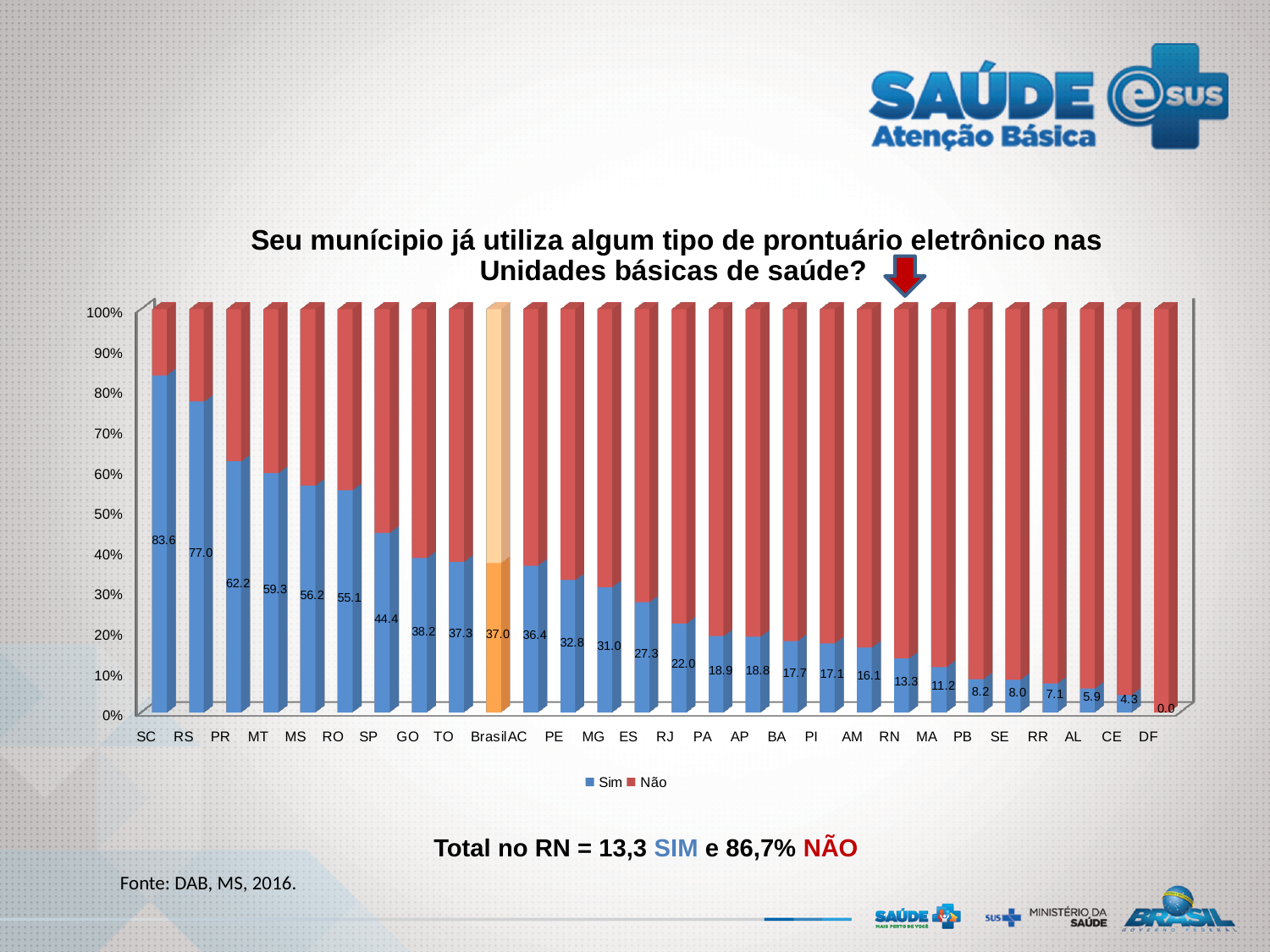
What is the difference between the Sim values for SC and RS? 6.6 Which category has the highest Sim value? SC How many categories are shown on the x axis? 28 Is the Não value for SC greater or less than 20%? less Which has a larger Sim value, PE or ES? PE Which category has the lowest Sim value? DF What kind of chart is shown? Stacked bar chart What is the Sim value for Brasil? 37.0 How many series does the legend list? 2 Do the Sim values rise or fall from left to right along the x axis? Fall What is the Sim value for SC? 83.6 What is the Sim value for RN? 13.3